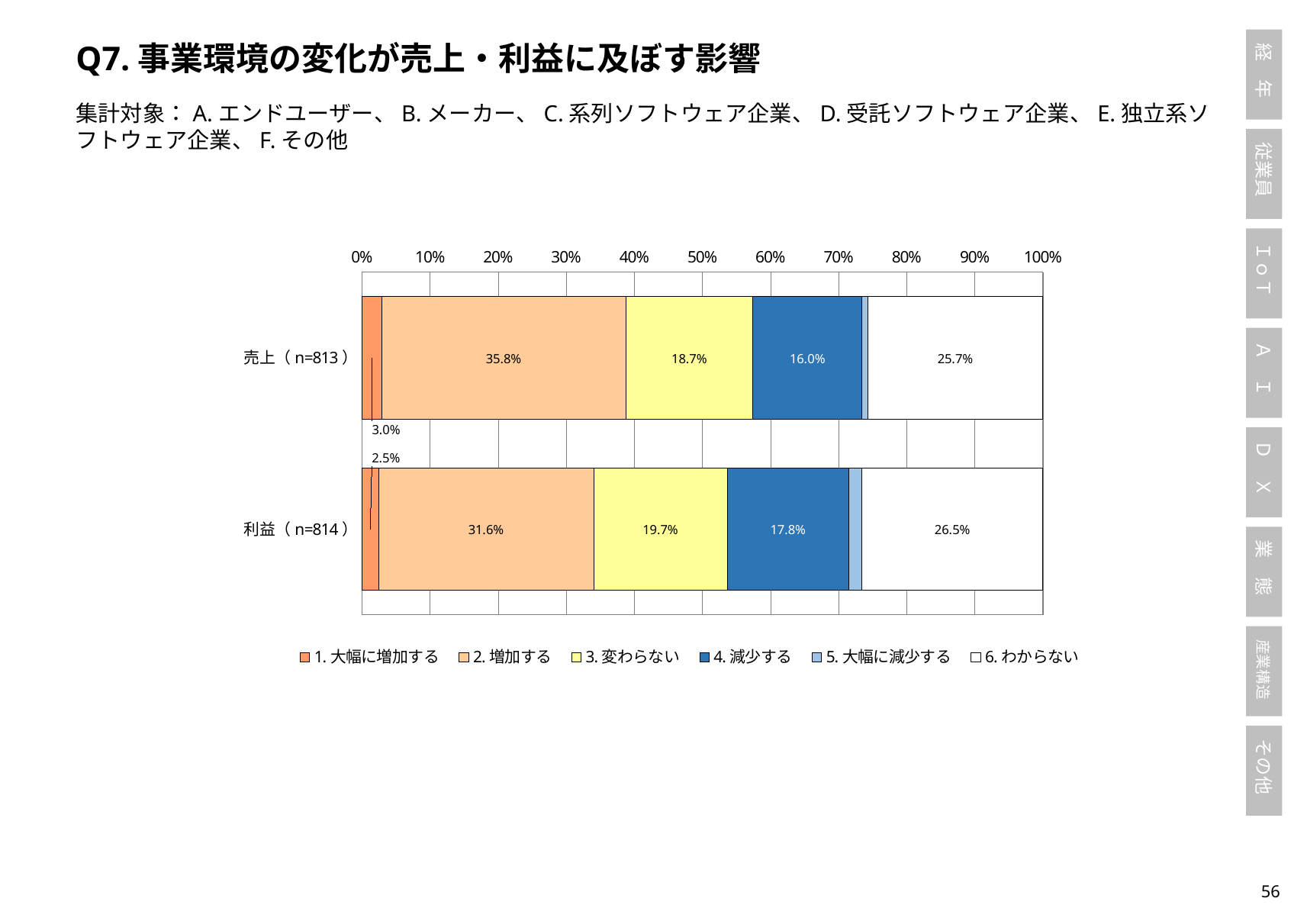
Is the value of 5. 大幅に減少する for 利益（n=814） greater or less than 10%? less Within the 売上（n=813） bar, which response has the largest share? 2. 増加する What percentage of respondents for 利益（n=814） answered 3. 変わらない? 19.7% How many series does the legend list? 6 What is the value of 4. 減少する for 売上（n=813）? 16.0% How many bars (categories) are shown in the chart? 2 What percentage of respondents for 売上（n=813） answered 2. 増加する? 35.8% How much larger is the 4. 減少する share for 利益（n=814） than for 売上（n=813）? 1.8 percentage points What is the difference between the 2. 増加する shares for 売上（n=813） and 利益（n=814）? 4.2 percentage points What kind of chart is shown on the slide? Stacked horizontal bar chart What is the value of 6. わからない for 利益（n=814）? 26.5% Which has the larger share of 2. 増加する, 売上（n=813） or 利益（n=814）? 売上（n=813）